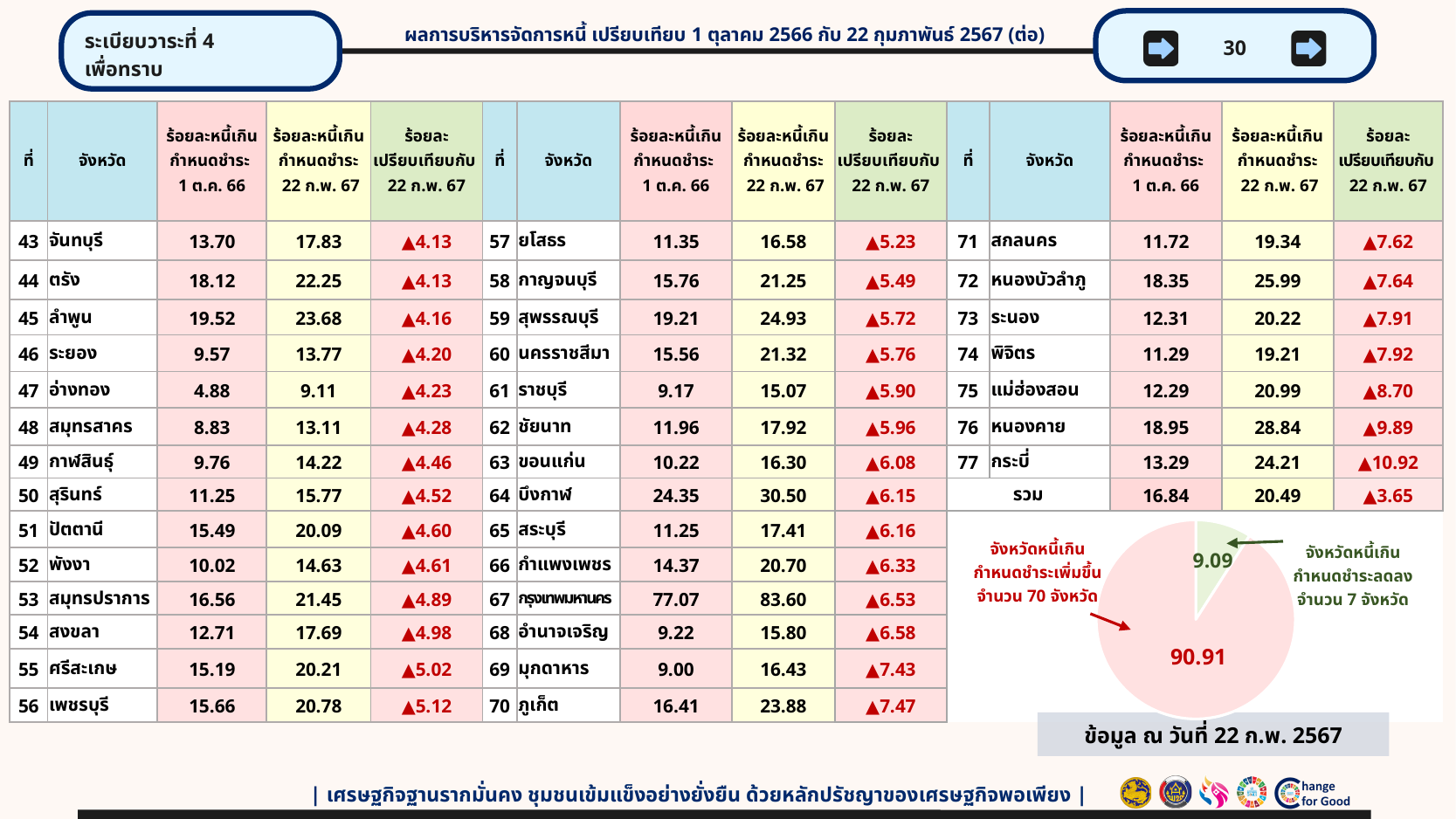
Which slice of the pie chart is the largest? จังหวัดหนี้เกินกำหนดชำระเพิ่มขึ้น (90.91) In the pie chart, what value is shown for the slice for provinces whose overdue debt increased (จังหวัดหนี้เกินกำหนดชำระเพิ่มขึ้น)? 90.91 Which slice of the pie chart is the smallest? จังหวัดหนี้เกินกำหนดชำระลดลง (9.09) What is the difference between the two slice values in the pie chart (90.91 and 9.09)? 81.82 In the pie chart, is the slice for provinces with increased overdue debt larger or smaller than the slice for provinces with decreased overdue debt? larger What kind of chart is shown at the bottom right of the slide? pie chart In the pie chart, what value is shown for the slice for provinces whose overdue debt decreased (จังหวัดหนี้เกินกำหนดชำระลดลง)? 9.09 According to the annotation on the pie chart, how many provinces had a decrease in overdue debt? 7 จังหวัด According to the annotation on the pie chart, how many provinces had an increase in overdue debt? 70 จังหวัด What share of the pie chart is taken by the slice for provinces whose overdue debt decreased? 9.09 What do the two slice values of the pie chart add up to? 100.00 How many slices does the pie chart have? 2